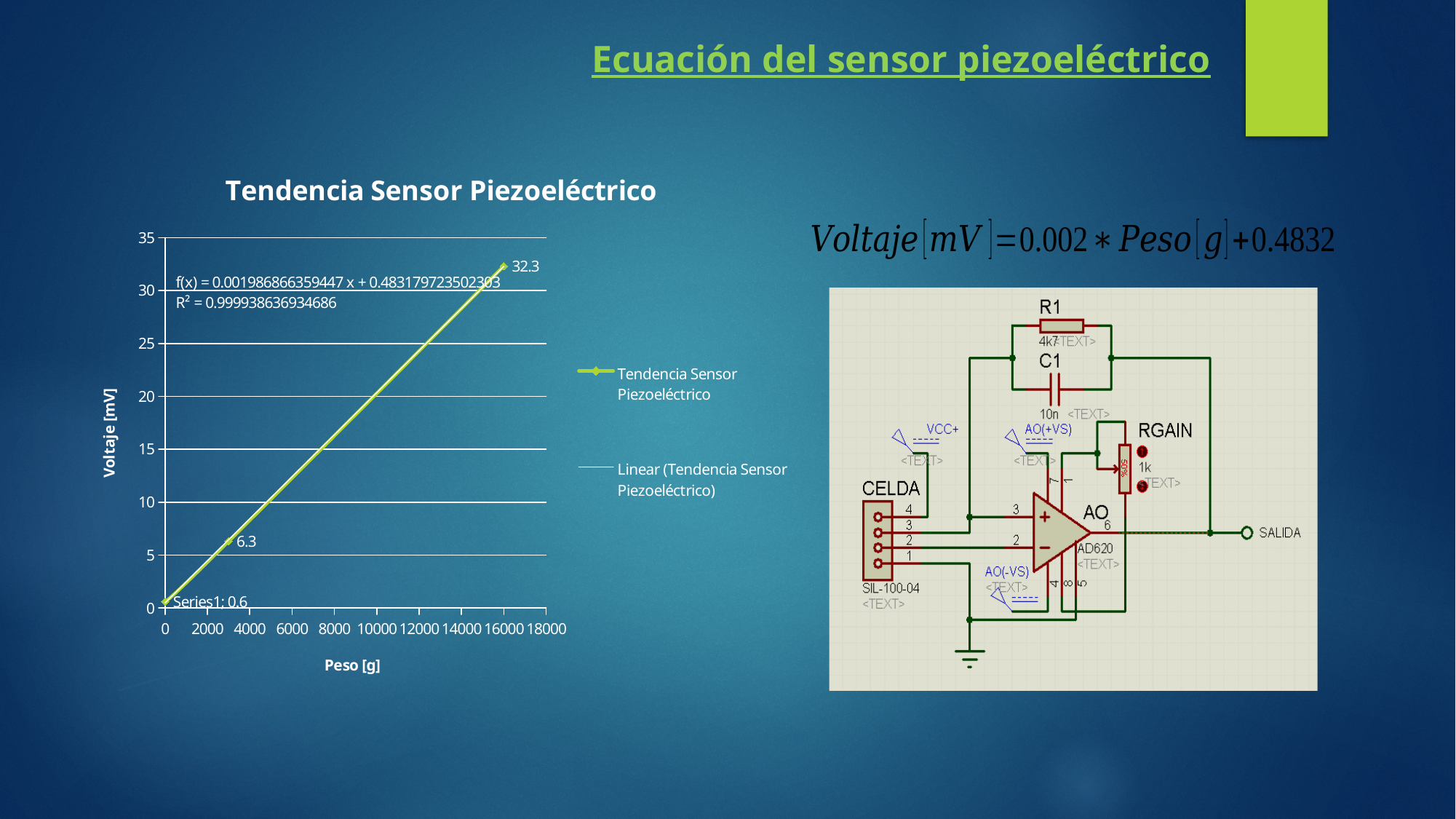
What is the highest Voltaje value labelled on the chart? 32.3 Which labelled value is larger, 6.3 or 32.3? 32.3 What is the title of the chart? Tendencia Sensor Piezoeléctrico What kind of chart is shown on the slide? line chart What is the label of the y axis? Voltaje [mV] What is the lowest Voltaje value labelled on the chart? 0.6 What is the difference between the highest labelled value (32.3) and the lowest labelled value (0.6)? 31.7 What is the Voltaje value of the data point at Peso 0 g? 0.6 Does the Voltaje rise or fall as Peso increases along the x axis? rises What is the difference between the labelled values 32.3 and 6.3? 26.0 How many entries does the chart legend list? 2 How many data points are plotted in the chart? 3